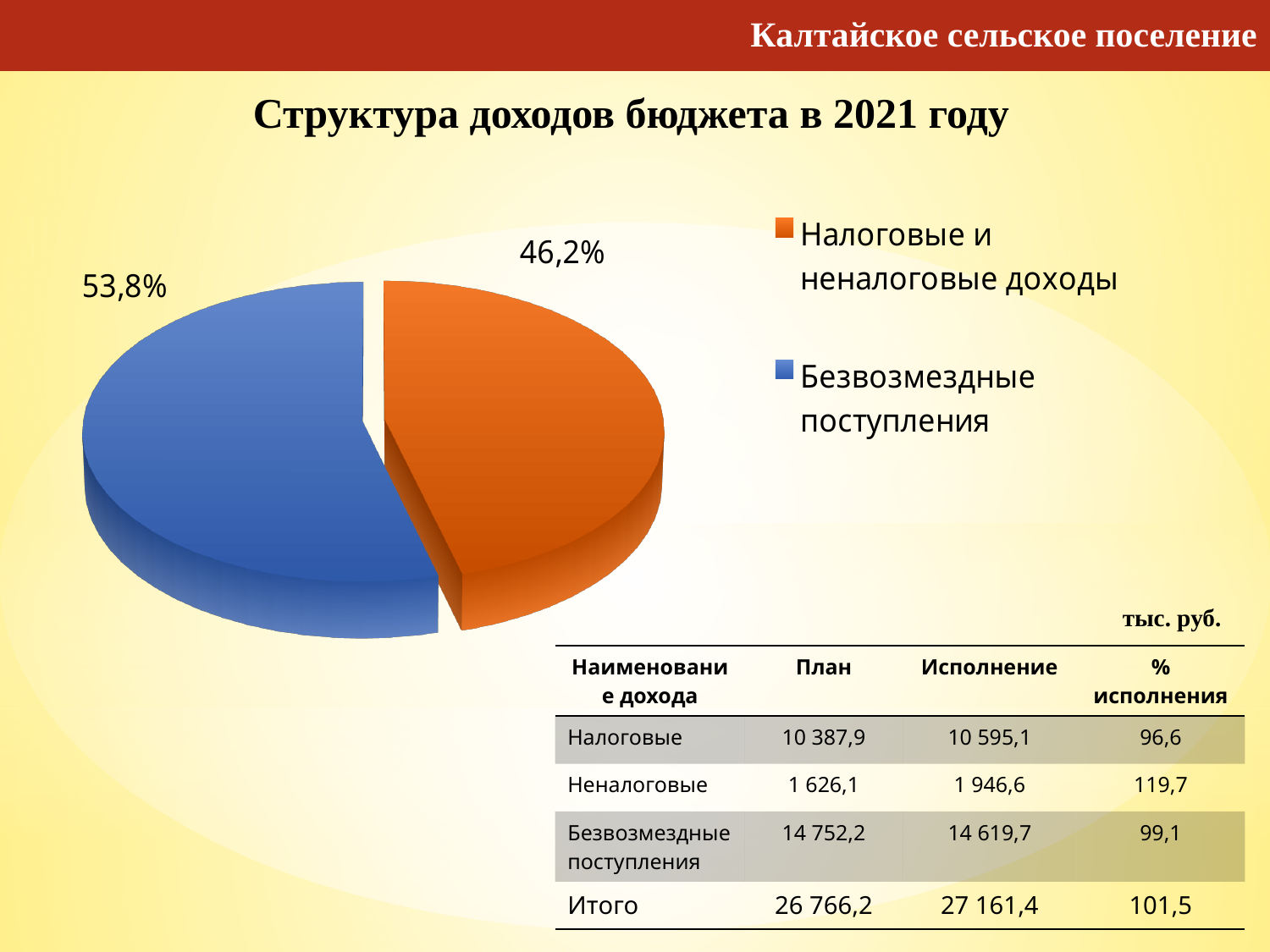
How many entries does the legend list? 2 What share of the pie does "Безвозмездные поступления" have? 53,8% What share of the pie does "Налоговые и неналоговые доходы" have? 46,2% What kind of chart is shown on the slide? Pie chart What colour is the "Безвозмездные поступления" slice? Blue How many slices does the pie chart have? 2 Which slice of the pie is the smallest? Налоговые и неналоговые доходы What is the difference in percentage points between the "Безвозмездные поступления" slice and the "Налоговые и неналоговые доходы" slice? 7,6 Which slice of the pie is the largest? Безвозмездные поступления What is the title of the chart? Структура доходов бюджета в 2021 году Which is larger: the share of "Безвозмездные поступления" or the share of "Налоговые и неналоговые доходы"? Безвозмездные поступления